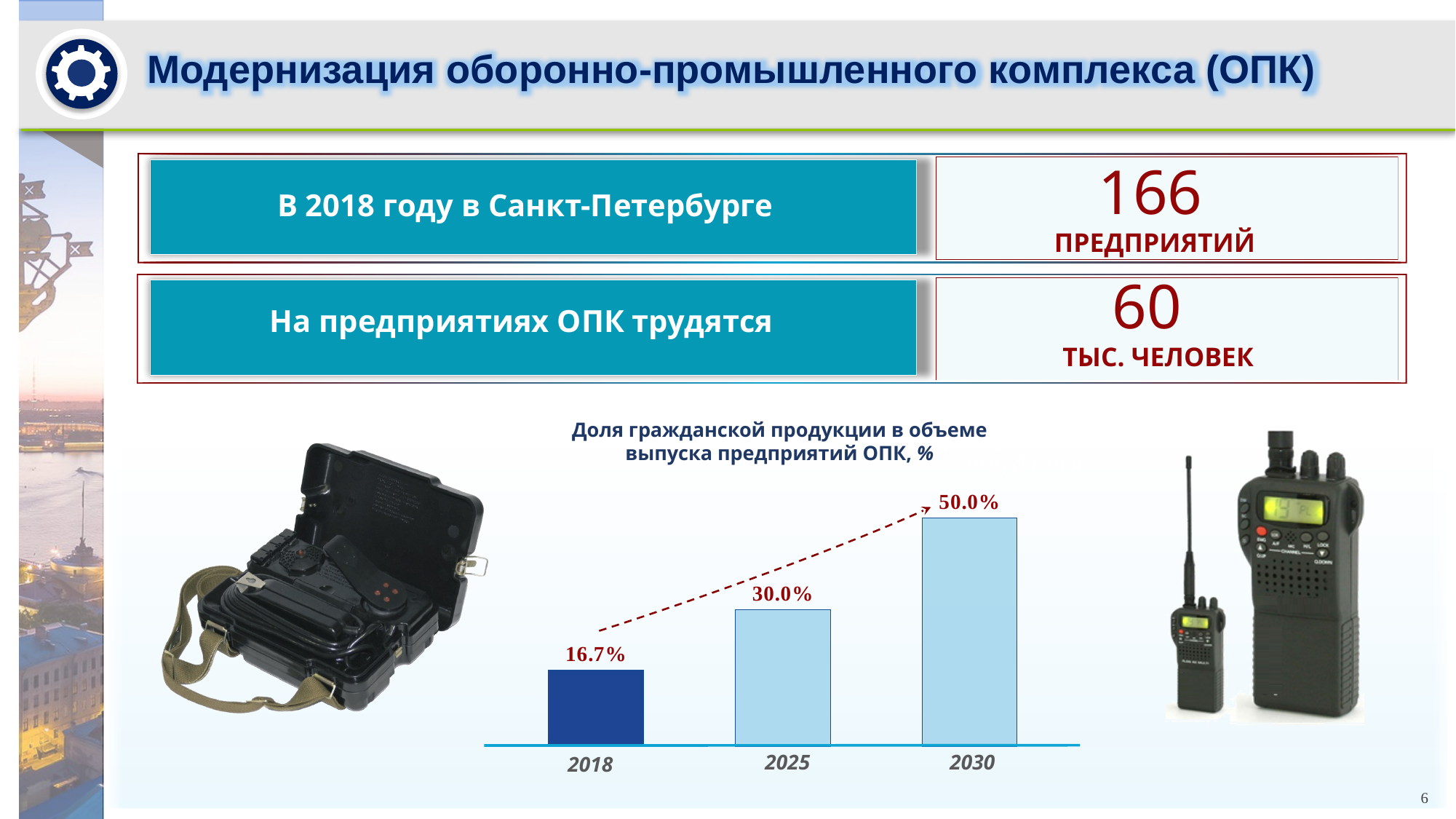
Do the values rise or fall from 2018 to 2030? rise What is the value for 2018 in the chart? 16.7% Which year has the lowest value in the chart? 2018 Which is larger, the value for 2025 or the value for 2030? 2030 What is the title of the chart? Доля гражданской продукции в объеме выпуска предприятий ОПК, % Which year has the highest value in the chart? 2030 What is the difference between the values for 2030 and 2018? 33.3% What is the value for 2030 in the chart? 50.0% What is the difference between the values for 2025 and 2018? 13.3% How many years are shown on the x axis of the chart? 3 What is the value for 2025 in the chart? 30.0% What kind of chart is shown on the slide? bar chart